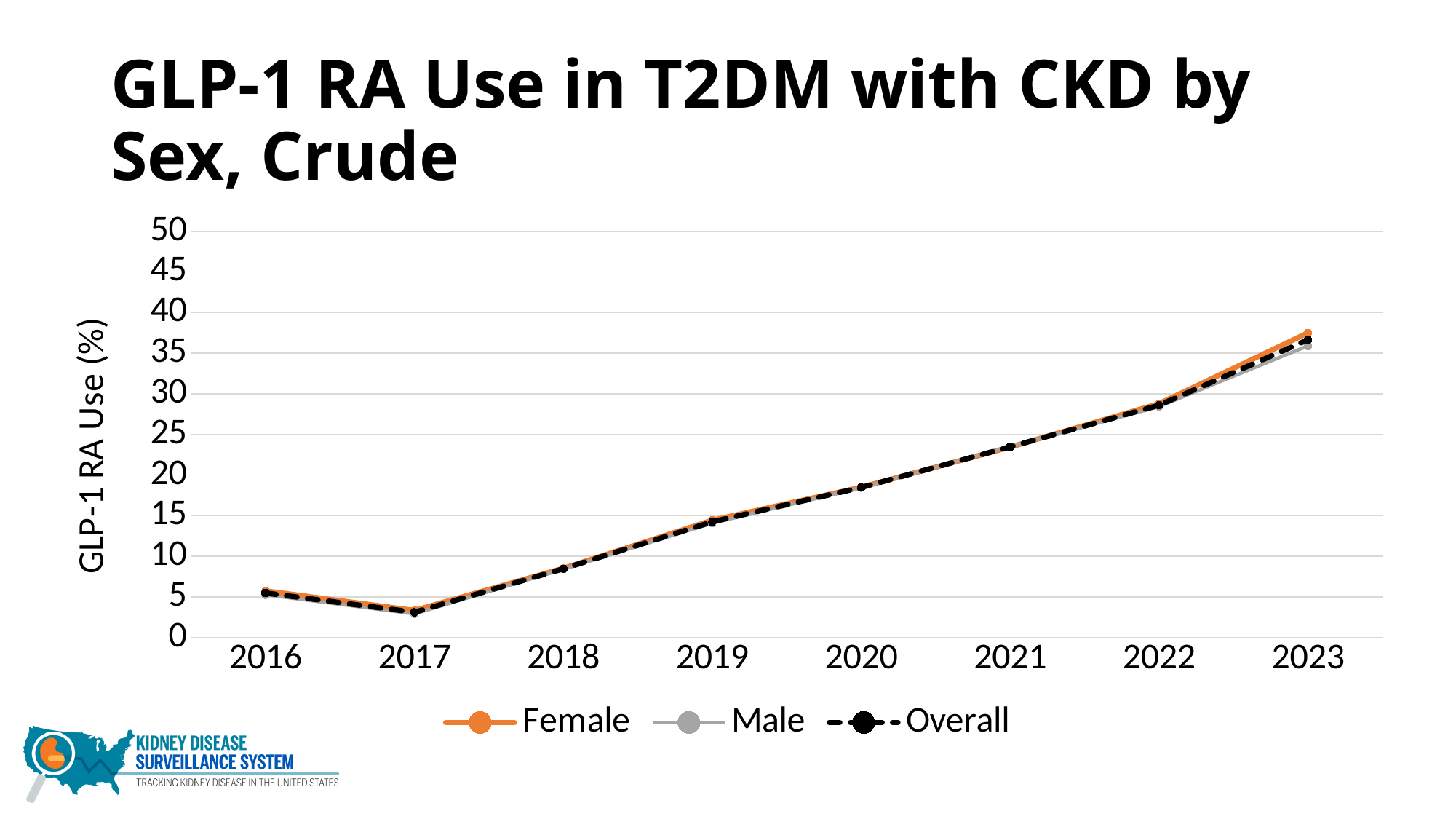
Is the Overall value for 2022 greater or less than 30? less Is the Overall value for 2020 greater or less than 20? less Is the Overall value for 2023 greater or less than 35? greater Which series is drawn with a dashed black line? Overall How many series does the legend list? 3 In which year is the Overall GLP-1 RA use highest? 2023 In which year is the Overall GLP-1 RA use lowest? 2017 How many years are plotted along the x axis? 8 What kind of chart is shown on the slide? line chart Do the values rise or fall along the x axis from 2017 to 2023? rise What is the label of the y axis? GLP-1 RA Use (%)